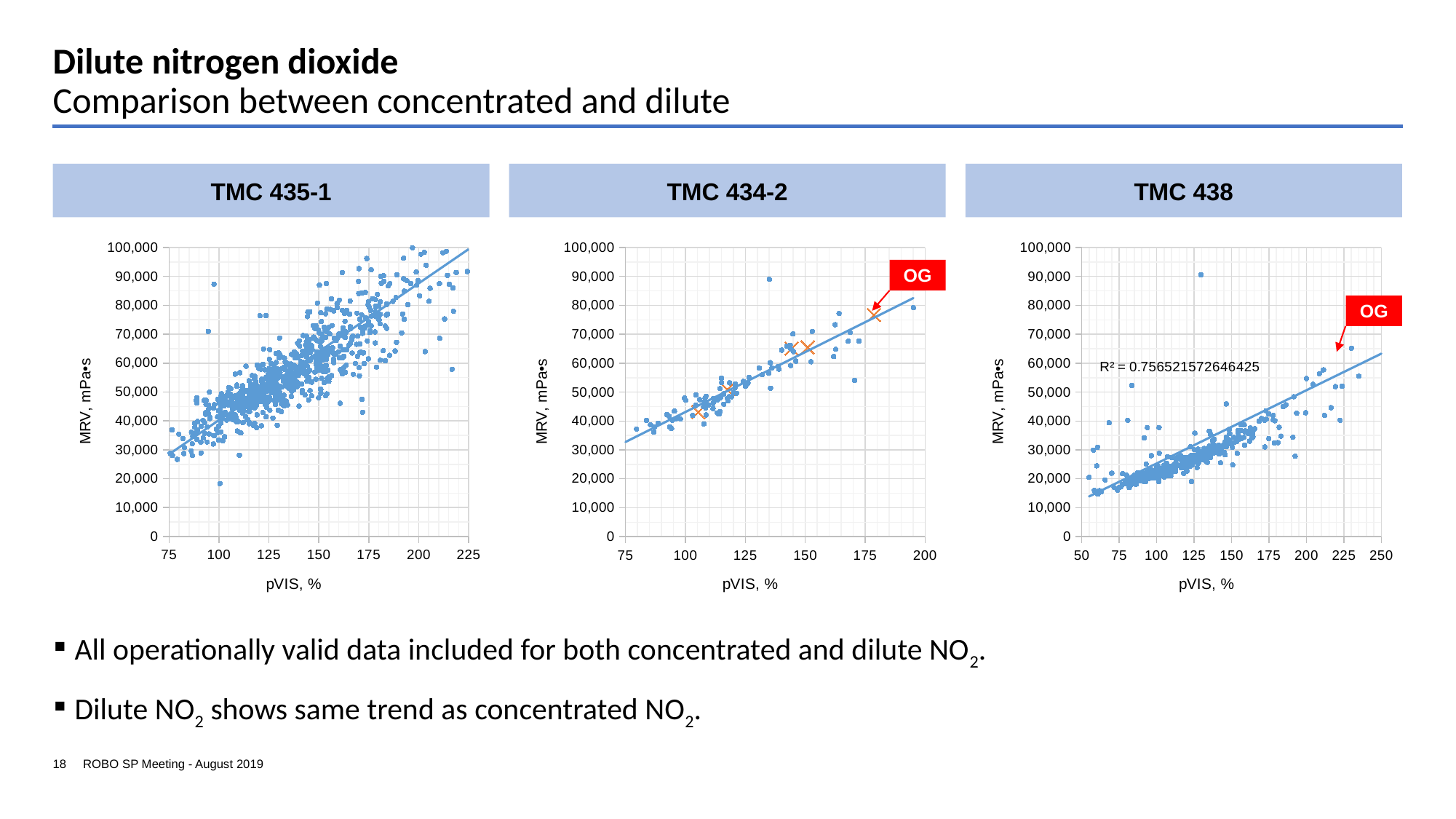
Which charts on the slide carry a red 'OG' annotation? TMC 434-2 and TMC 438 What kind of chart is used for TMC 435-1? Scatter chart In the TMC 438 chart, what R² value is printed? R² = 0.756521572646425 How many charts are shown on the slide? 3 In the TMC 438 chart, does MRV rise or fall as pVIS increases along the x axis? Rises In the TMC 434-2 chart, is the lowest plotted MRV value greater or less than 50,000? less In the TMC 438 chart, is the lowest plotted MRV value greater or less than 20,000? less What is the y-axis title on the TMC 434-2 chart? MRV, mPa•s In the TMC 435-1 chart, does MRV rise or fall as pVIS increases? Rises